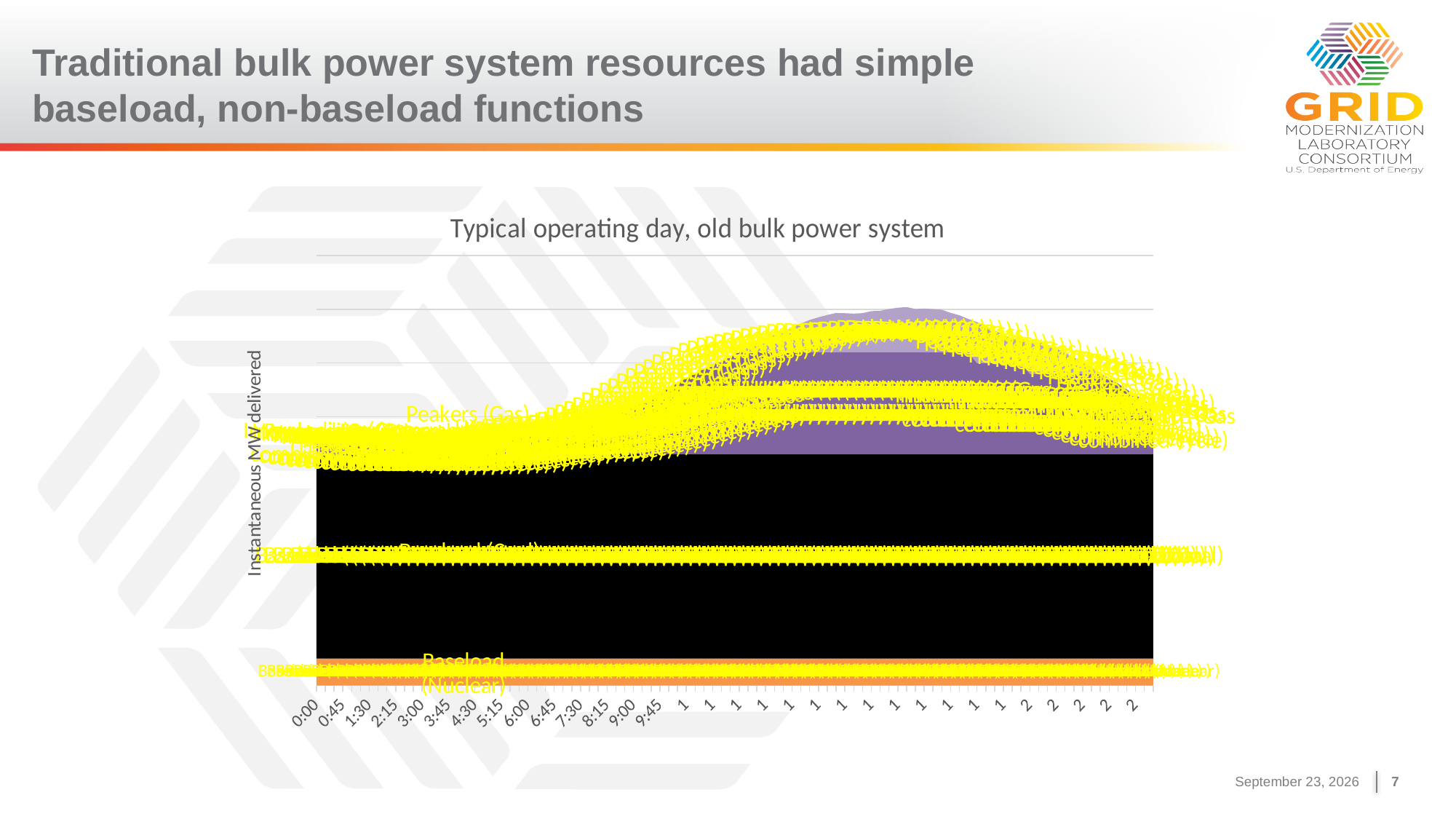
Does the Baseload (Coal) area stay flat or change across the day? Stay flat What kind of chart is shown on the slide? Area chart Which series sits at the bottom of the stacked area chart? Baseload (Nuclear) How many resource series are labelled in the chart? 4 Does the Peakers (Gas) area rise or fall between 0:00 and the middle of the day? Rise What is the title of the chart? Typical operating day, old bulk power system